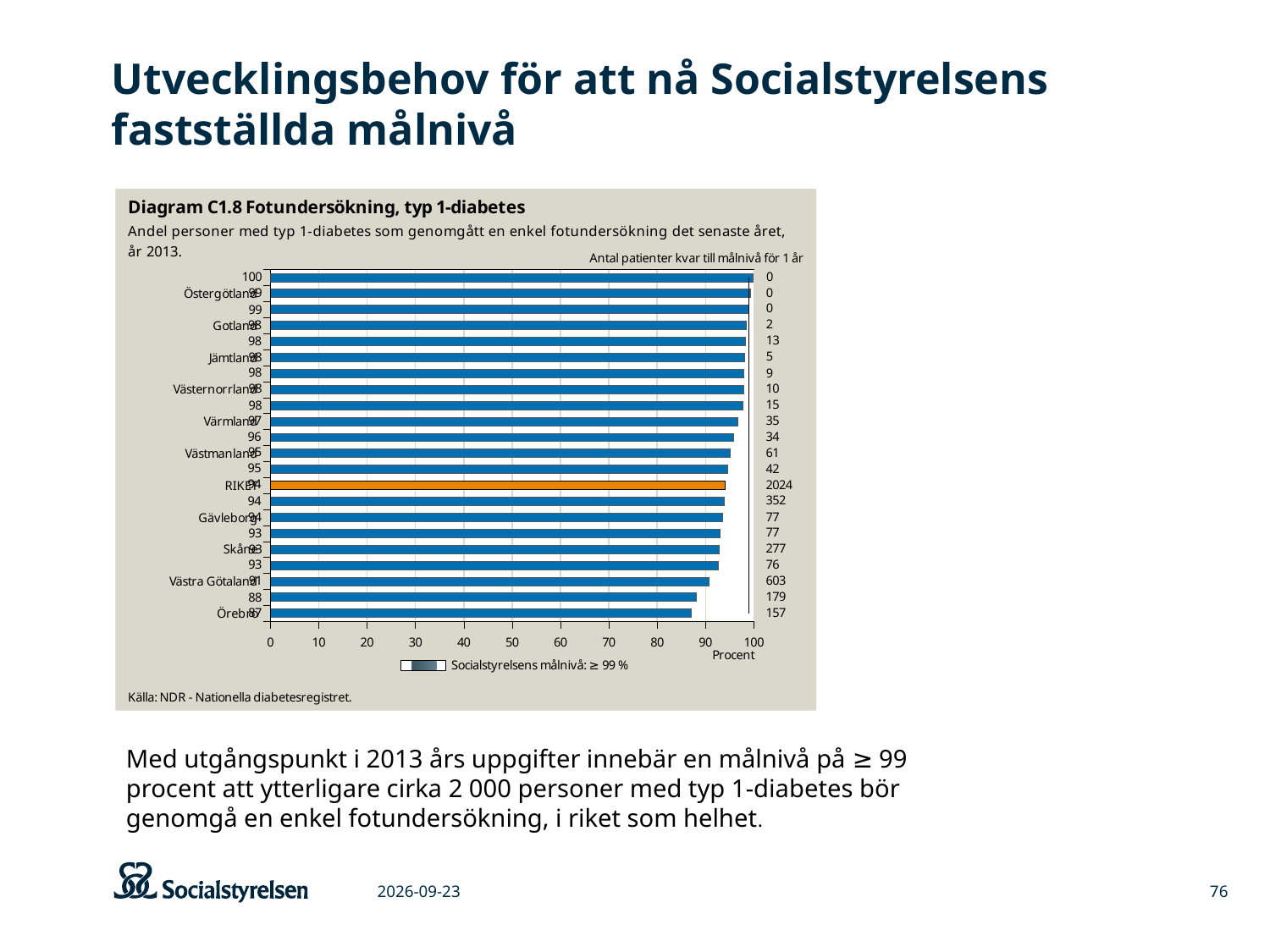
What type of chart is shown in Diagram C1.8? bar chart Which has a higher percentage in Diagram C1.8, Skåne or Värmland? Värmland How many bars are plotted in Diagram C1.8? 22 What is the value (percent) for Östergötland in Diagram C1.8? 99 What is the value (percent) for RIKET in Diagram C1.8? 94 How many patients remain to reach the target level (Antal patienter kvar till målnivå) for RIKET? 2024 How many patients remain to reach the target level for Västra Götaland? 603 Which labelled region has the lowest percentage in Diagram C1.8? Örebro What is the value (percent) for Västra Götaland in Diagram C1.8? 91 What is the value (percent) for Örebro in Diagram C1.8? 87 What target level (målnivå) is stated in the legend of Diagram C1.8? ≥ 99 % What is the difference in percent between Östergötland and Örebro in Diagram C1.8? 12